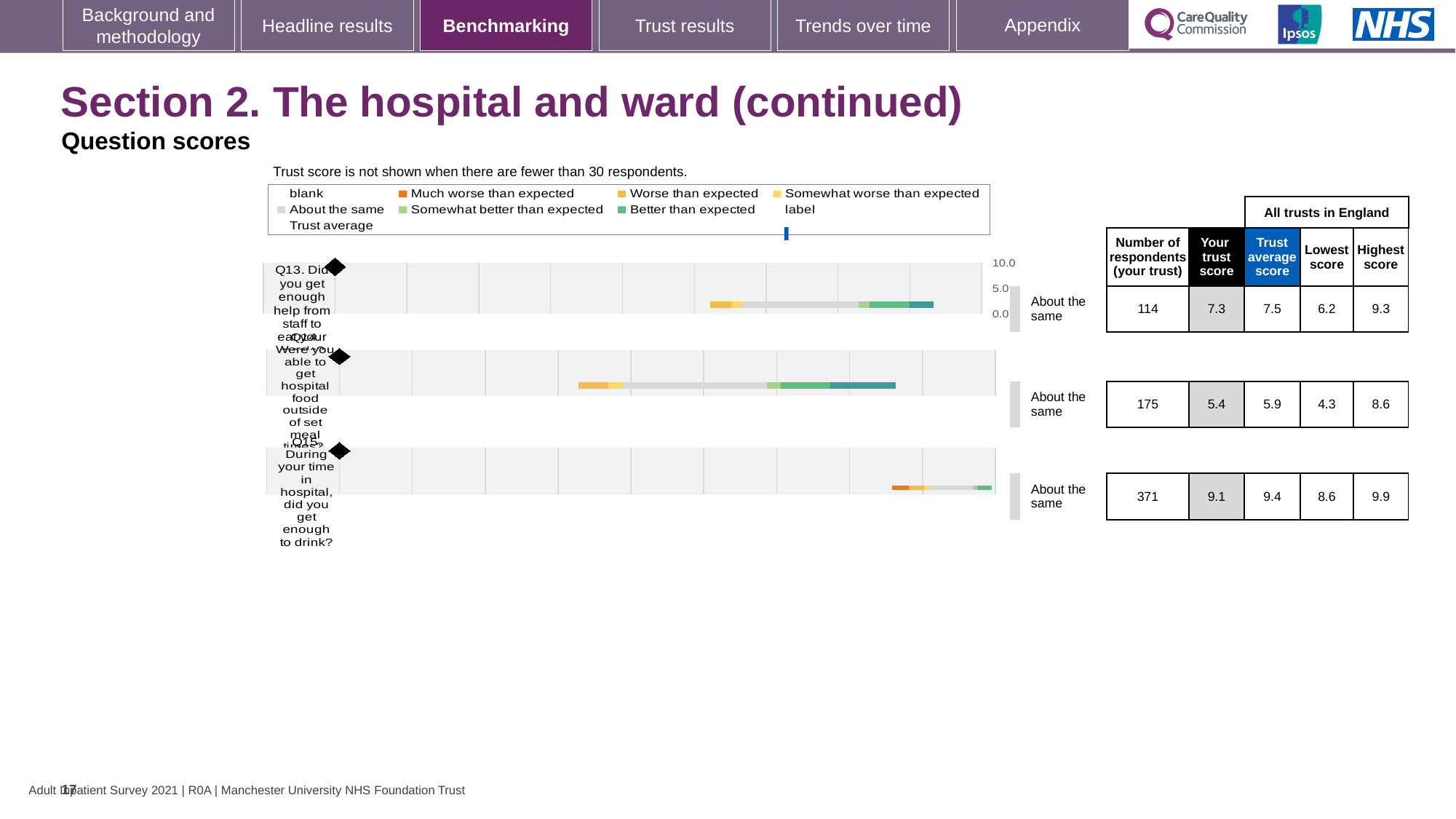
For Q15, what is the difference between the highest score (9.9) and the lowest score (8.6)? 1.3 For Q14, which is larger: your trust score or the trust average score? Trust average score For Q13, what is the difference between the trust average score (7.5) and your trust score (7.3)? 0.2 How is the trust's performance categorised for Q13, Q14 and Q15 relative to expectations? About the same What is the highest score among all trusts in England for Q14? 8.6 What is the trust average score for Q15 (did you get enough to drink?)? 9.4 Which question has the lowest 'Your trust score'? Q14 How many respondents from the trust answered Q14 (Were you able to get hospital food outside of set meal times?)? 175 How many questions (categories) are plotted in the chart? 3 What is the 'Your trust score' for Q13 (Did you get enough help from staff to eat your meals?)? 7.3 What kind of chart is used to show the question scores on this slide? bar chart Which question has the highest 'Your trust score'? Q15